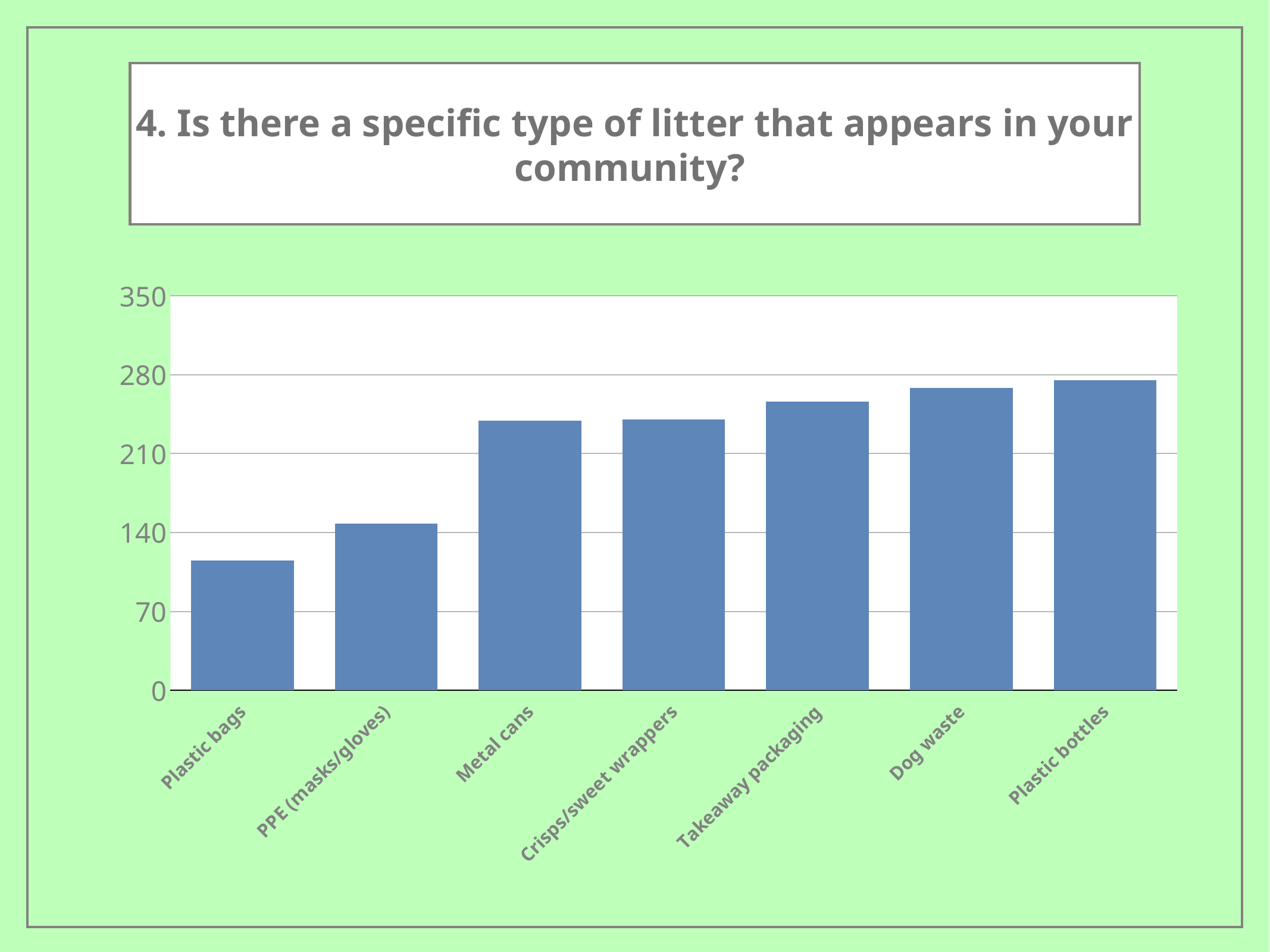
Do the values generally rise or fall from left to right across the categories? rise What is the title of the chart? 4. Is there a specific type of litter that appears in your community? Which is larger, the value for Plastic bags or the value for Metal cans? Metal cans Is the value for PPE (masks/gloves) greater or less than 140? greater Which litter category has the highest value? Plastic bottles Is the value for Takeaway packaging greater or less than 280? less What kind of chart is shown on the slide? bar chart Is the value for Metal cans greater or less than 210? greater Which litter category has the lowest value? Plastic bags How many litter categories are shown on the chart? 7